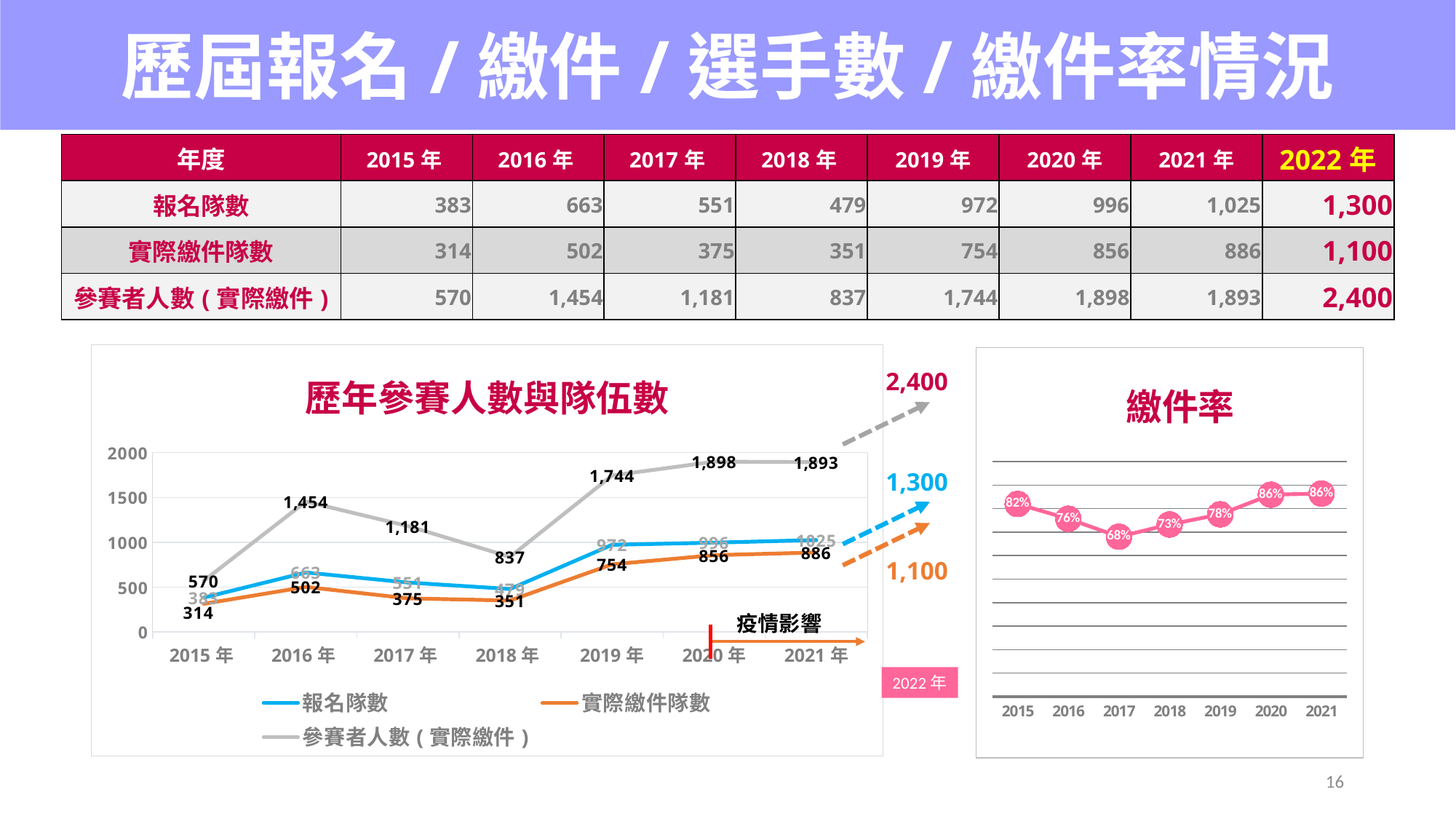
In the chart titled 歷年參賽人數與隊伍數, which year has the highest value for 參賽者人數（實際繳件）? 2020 年 In the chart titled 歷年參賽人數與隊伍數, which year has the lowest value for 參賽者人數（實際繳件）? 2015 年 In the chart titled 歷年參賽人數與隊伍數, is the value of 實際繳件隊數 for 2020 年 greater or less than 1000? less In the chart titled 歷年參賽人數與隊伍數, what is the value of 實際繳件隊數 for 2017 年? 375 What kind of chart is the chart titled 繳件率? line chart In the chart titled 繳件率, is the value for 2019 larger or smaller than the value for 2016? larger In the chart titled 繳件率, how many years are plotted on the x axis? 7 In the chart titled 繳件率, which year has the lowest value? 2017 In the chart titled 歷年參賽人數與隊伍數, what is the value of 參賽者人數（實際繳件） for 2019 年? 1,744 In the chart titled 歷年參賽人數與隊伍數, what is the difference between 參賽者人數（實際繳件） in 2016 年 and 2017 年? 273 In the chart titled 繳件率, what is the value for 2017? 68% In the chart titled 歷年參賽人數與隊伍數, how many series does the legend list? 3